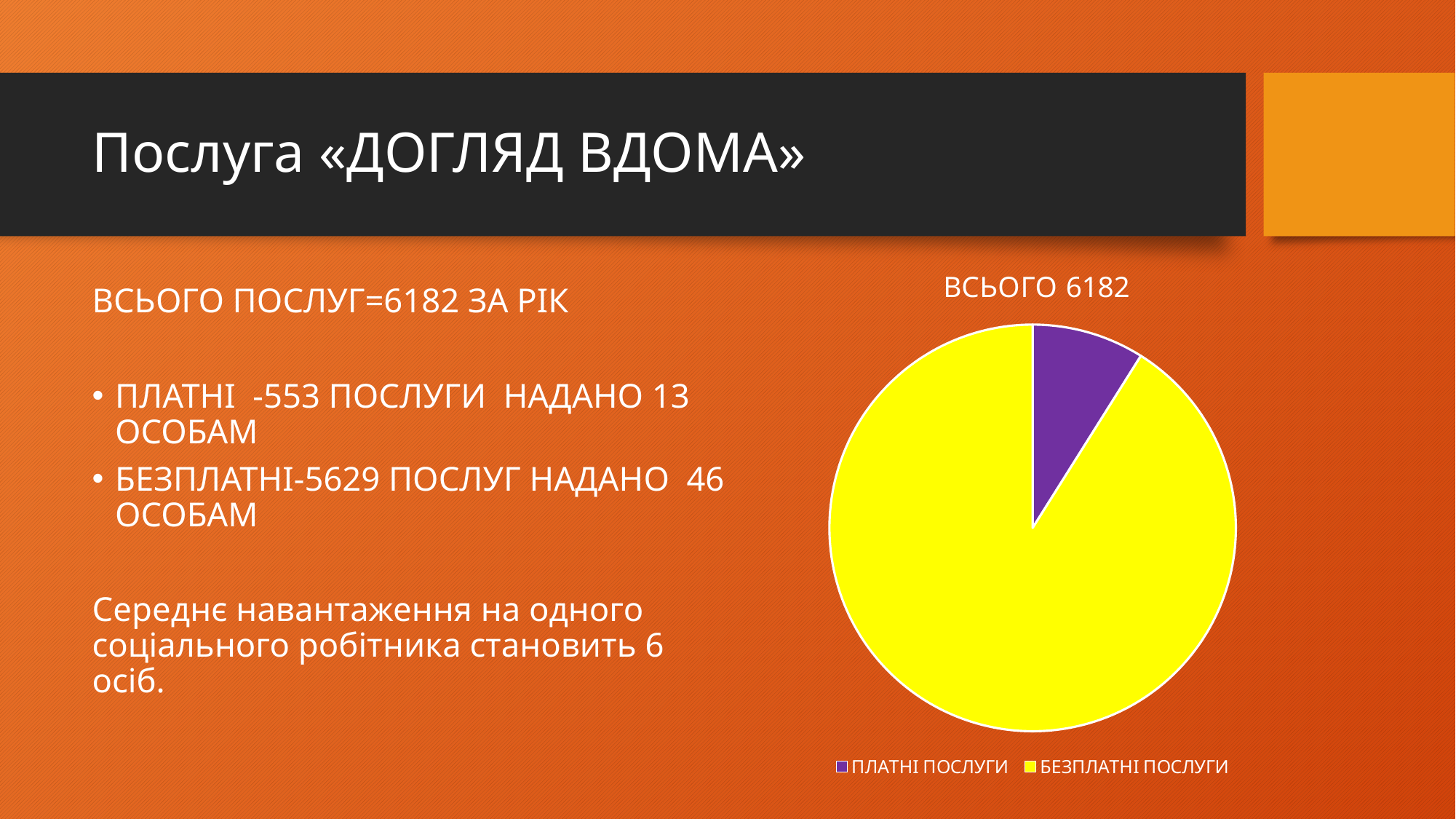
According to the slide, how many БЕЗПЛАТНІ ПОСЛУГИ (free services) are represented in the pie chart? 5629 How many slices does the pie chart have? 2 What colour is the ПЛАТНІ ПОСЛУГИ slice in the pie chart? purple According to the slide, how many ПЛАТНІ ПОСЛУГИ (paid services) are represented in the pie chart? 553 What is the total number of services represented by the whole pie chart? 6182 What kind of chart is shown on the slide? pie chart By how much does the number of БЕЗПЛАТНІ ПОСЛУГИ exceed the number of ПЛАТНІ ПОСЛУГИ, using the values given on the slide? 5076 Which slice of the pie chart is the smallest? ПЛАТНІ ПОСЛУГИ Which slice of the pie chart is the largest? БЕЗПЛАТНІ ПОСЛУГИ How many entries does the legend of the pie chart list? 2 Which is larger in the pie chart, ПЛАТНІ ПОСЛУГИ or БЕЗПЛАТНІ ПОСЛУГИ? БЕЗПЛАТНІ ПОСЛУГИ What is the title of the pie chart? ВСЬОГО 6182